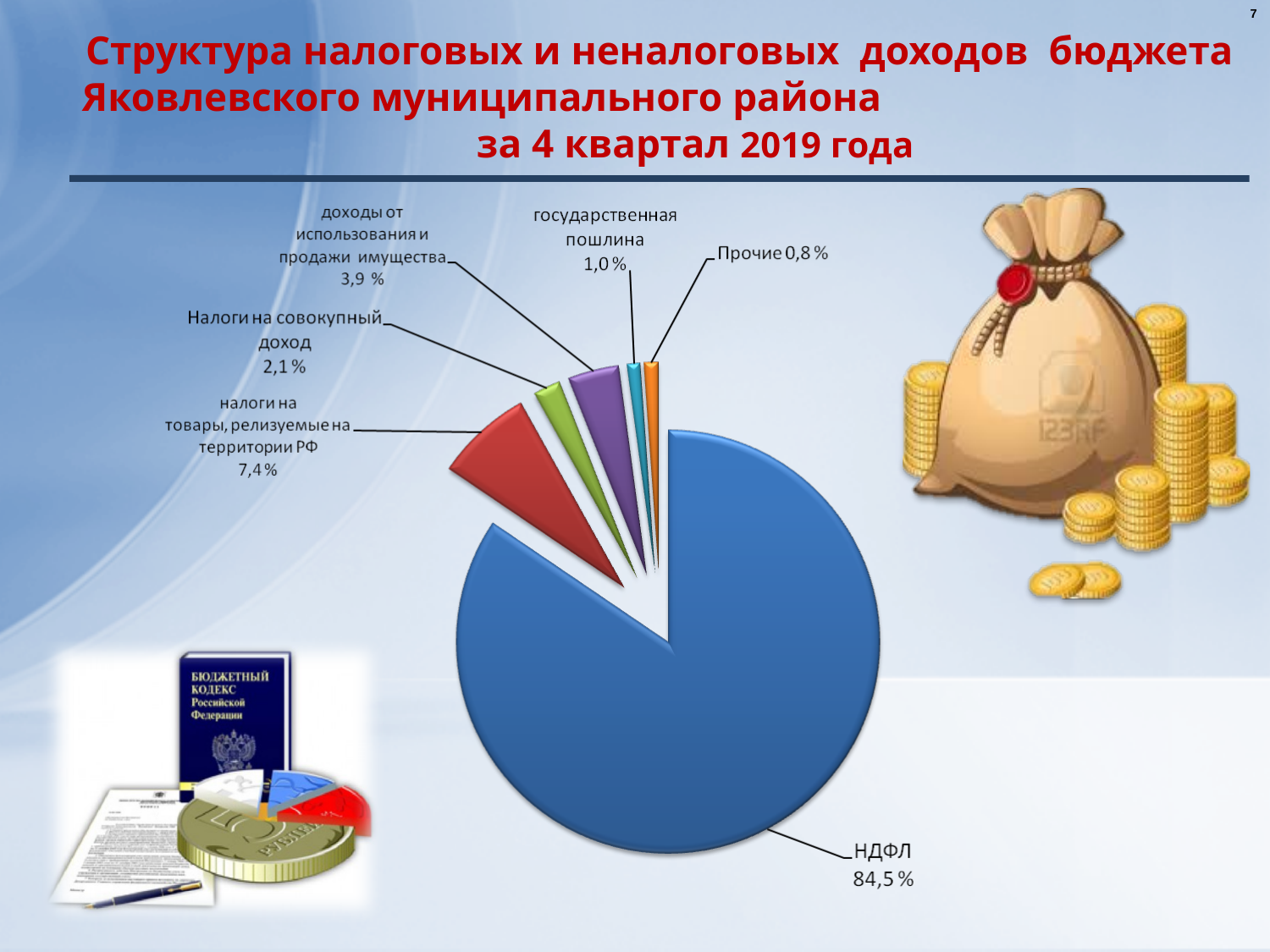
What is the value for Прочие? 0,8 % What is the value for Налоги на совокупный доход? 2,1 % What share is shown for государственная пошлина? 1,0 % What percentage is shown for доходы от использования и продажи имущества? 3,9 % How many slices does the pie chart have? 6 What type of chart is shown on the slide? Pie chart Which is larger: the share of Налоги на совокупный доход or the share of государственная пошлина? Налоги на совокупный доход What is the difference between the share of НДФЛ and the share of налоги на товары, реализуемые на территории РФ? 77,1 % What share of the pie does НДФЛ account for? 84,5 % Which category has the largest share of the pie? НДФЛ What is the value shown for налоги на товары, реализуемые на территории РФ? 7,4 % Which category has the smallest share of the pie? Прочие